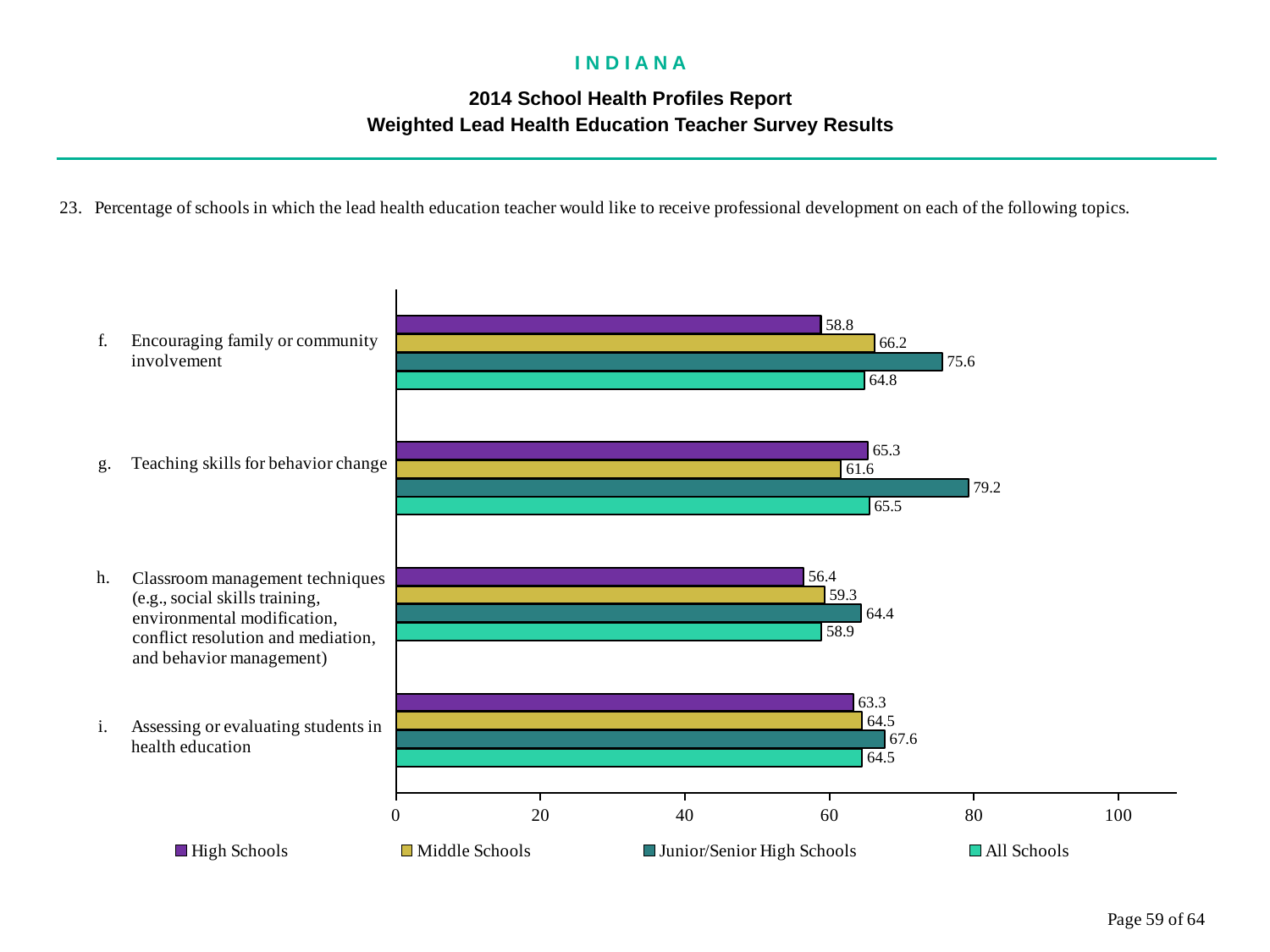
How many series does the legend list? 4 What is the value for High Schools for "Encouraging family or community involvement"? 58.8 What is the value for Junior/Senior High Schools for "Teaching skills for behavior change"? 79.2 What is the Middle Schools value for "Assessing or evaluating students in health education"? 64.5 What is the difference between the Junior/Senior High Schools and High Schools values for "Teaching skills for behavior change"? 13.9 For "Encouraging family or community involvement", which is larger: the Middle Schools value or the High Schools value? Middle Schools Which topic has the highest Junior/Senior High Schools value? Teaching skills for behavior change Which topic has the lowest High Schools value? Classroom management techniques What kind of chart is shown on the slide? Bar chart How many topics (categories) are shown on the chart? 4 What is the All Schools value for "Classroom management techniques"? 58.9 Is the Junior/Senior High Schools value for "Encouraging family or community involvement" greater or less than 60? greater